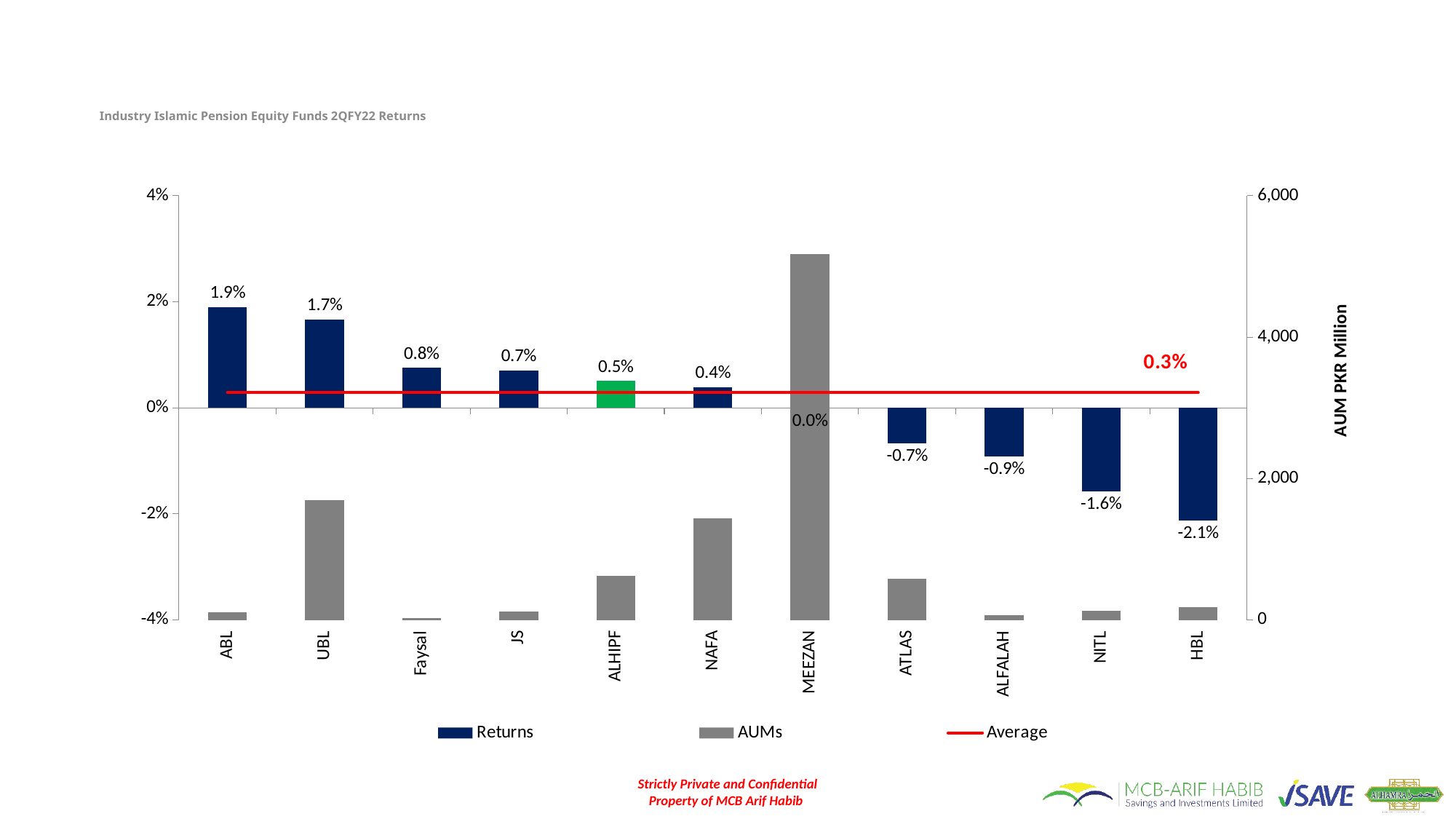
How many funds are shown on the x axis? 11 Which has the higher return, Faysal or JS? Faysal How many series does the legend list? 3 Is the AUM value for UBL greater or less than 2,000? less What is the return for MEEZAN? 0.0% What is the difference between the returns of ABL and UBL? 0.2% What is the return for ABL? 1.9% Which fund has the lowest return? HBL Is the AUM value for MEEZAN greater or less than 4,000? greater Which fund has the highest return? ABL What is the return for HBL? -2.1% Which fund has the largest AUM bar? MEEZAN